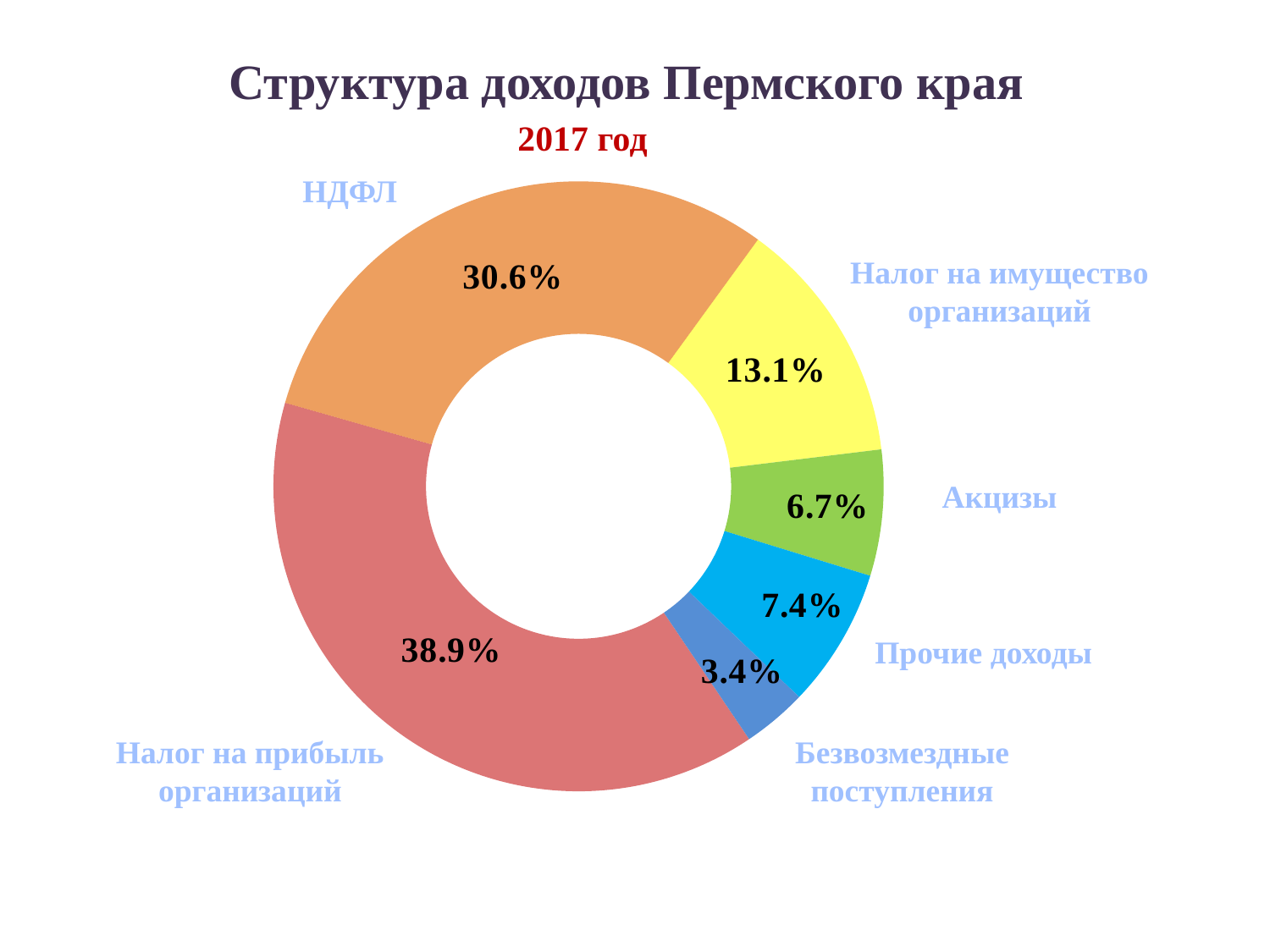
What percentage is shown for Акцизы? 6.7% What year does the chart refer to? 2017 год What colour is the segment for Налог на прибыль организаций? Red Which category has the largest share of revenue? Налог на прибыль организаций How many categories are shown in the chart? 6 What share of revenue does НДФЛ account for? 30.6% Which category has the smallest share of revenue? Безвозмездные поступления What is the difference in percentage points between Налог на прибыль организаций and НДФЛ? 8.3 Which is larger, Прочие доходы or Акцизы? Прочие доходы What is the value shown for Налог на имущество организаций? 13.1% What kind of chart is shown on the slide? Doughnut (pie) chart What is the value for Безвозмездные поступления? 3.4%